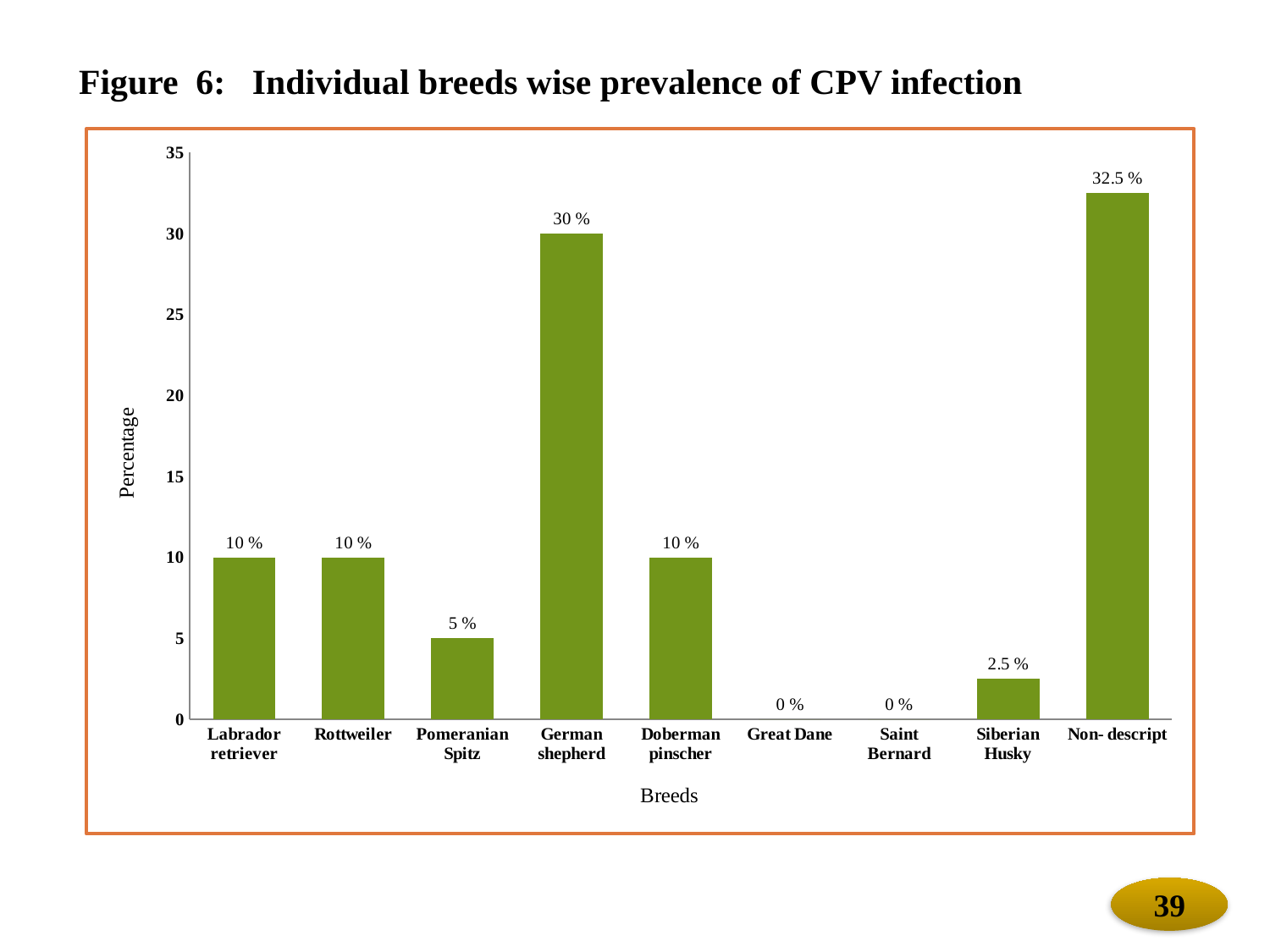
What is the prevalence of CPV infection for Siberian Husky? 2.5 % What is the difference in prevalence between Labrador retriever and Pomeranian Spitz? 5 % Is the value for German shepherd greater or less than 25? greater What is the difference in prevalence between Non- descript and German shepherd? 2.5 % What is the prevalence of CPV infection for German shepherd? 30 % What is the label of the y axis? Percentage What is the prevalence of CPV infection for Pomeranian Spitz? 5 % What kind of chart is shown on the slide? Bar chart How many breeds have a prevalence of 0 %? 2 Which breed has the highest prevalence of CPV infection? Non- descript How many breeds are shown on the x axis? 9 Which has a higher prevalence, Doberman pinscher or Siberian Husky? Doberman pinscher